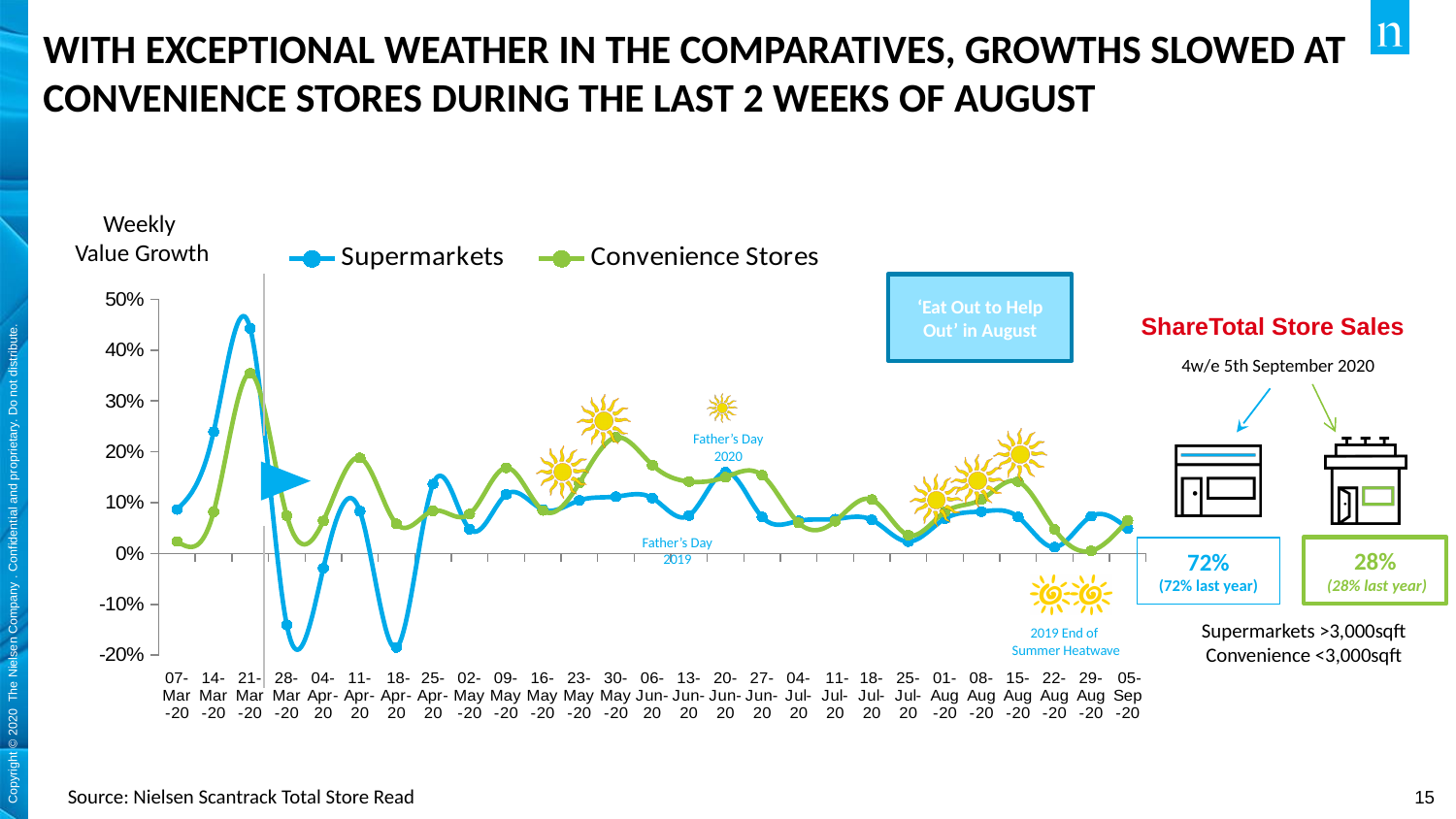
Is the Supermarkets value for 21-Mar-20 greater or less than 40%? greater At 28-Mar-20, which series has the higher value, Supermarkets or Convenience Stores? Convenience Stores What are the two series named in the chart legend? Supermarkets and Convenience Stores How many series does the chart legend list? 2 At which week does the Supermarkets line reach its lowest value? 18-Apr-20 What kind of chart is shown on the slide? line chart At which week does the Supermarkets line reach its highest value? 21-Mar-20 Is the Supermarkets value for 18-Apr-20 greater or less than -10%? less At which week does the Convenience Stores line reach its highest value? 21-Mar-20 Is the Convenience Stores value for 30-May-20 greater or less than 20%? greater How many weekly data points are plotted along the x axis of the chart? 27 From 07-Mar-20 to 21-Mar-20, does the Supermarkets line rise or fall? rise